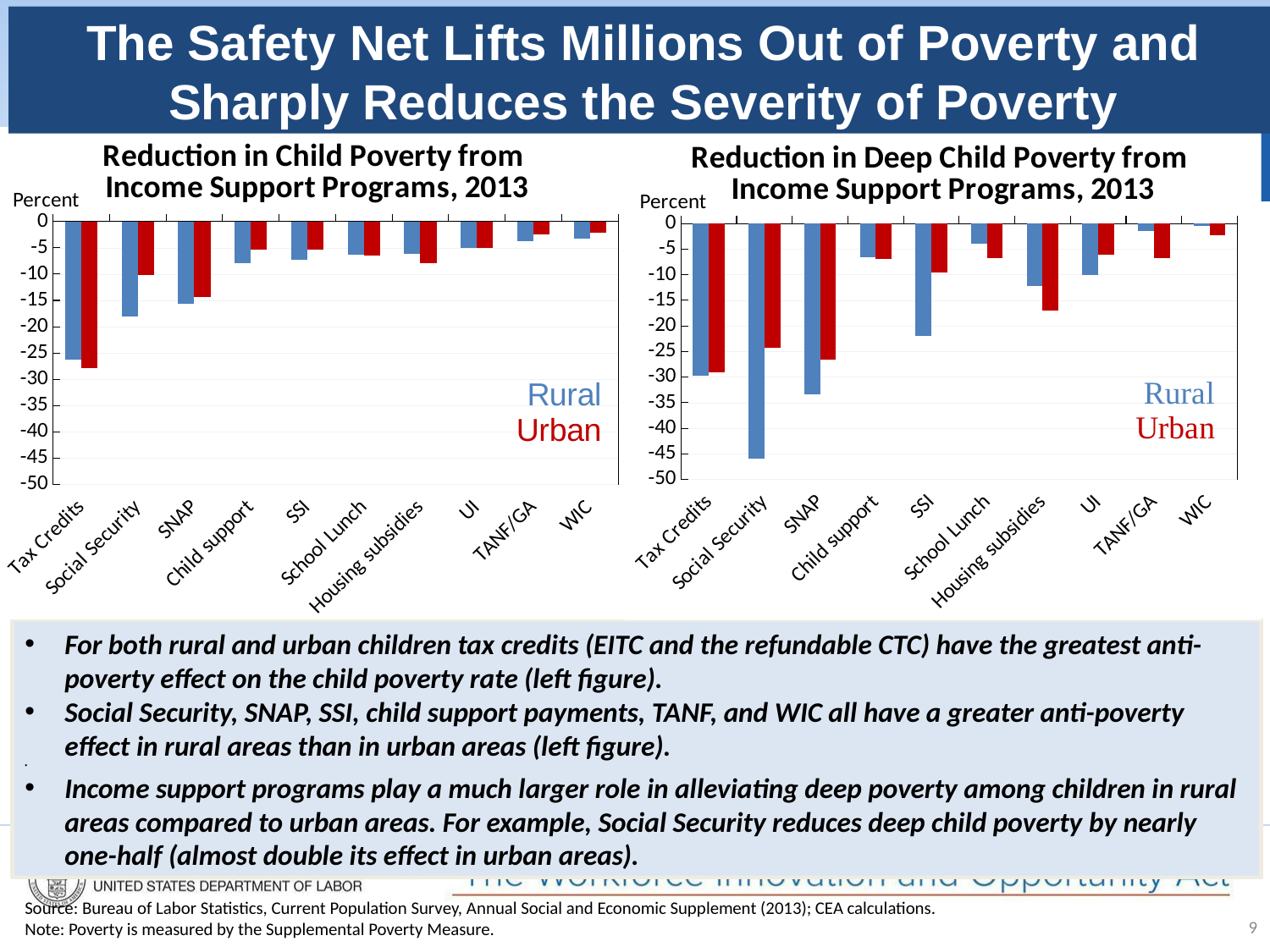
What colour represents the Urban series in both charts? red In the right chart, for SNAP, which series shows the larger reduction in deep child poverty, Rural or Urban? Rural In the right chart, is the Urban value for Social Security greater or less than -30? greater In the left chart, which category shows the smallest reduction in child poverty? WIC In the left chart, is the Urban value for Tax Credits greater or less than -20? less In the left chart, for Social Security, which series shows the larger reduction in child poverty, Rural or Urban? Rural In the left chart, which category shows the largest reduction in child poverty (the longest bars)? Tax Credits How many categories are shown on the x axis of the right chart, 'Reduction in Deep Child Poverty from Income Support Programs, 2013'? 10 In the right chart, is the Rural value for Social Security greater or less than -40? less What kind of chart is the left chart, 'Reduction in Child Poverty from Income Support Programs, 2013'? bar chart How many series does the legend of the left chart list? 2 In the right chart, which category has the lowest value (the longest bar)? Social Security